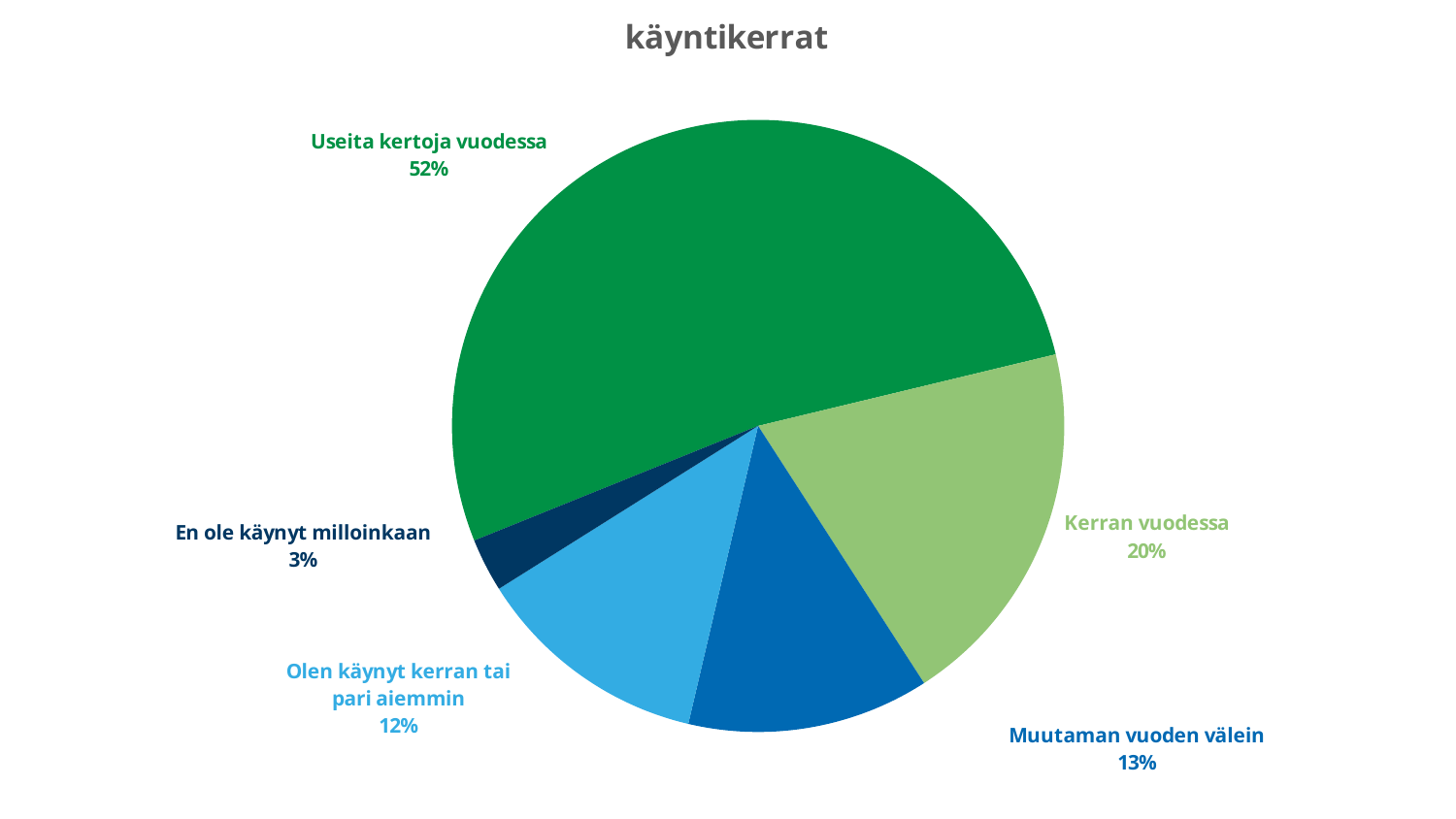
Which is larger, "Kerran vuodessa" or "Muutaman vuoden välein"? Kerran vuodessa What is the difference between "Useita kertoja vuodessa" and "Kerran vuodessa"? 32% How many slices does the pie chart have? 5 What is the value for "Olen käynyt kerran tai pari aiemmin"? 12% Which category has the smallest slice? En ole käynyt milloinkaan What is the value for "Kerran vuodessa"? 20% What is the title of the chart? käyntikerrat What is the value for "En ole käynyt milloinkaan"? 3% What share does "Useita kertoja vuodessa" have in the pie? 52% What kind of chart is shown on the slide? pie chart What is the value for "Muutaman vuoden välein"? 13% Which category has the largest slice? Useita kertoja vuodessa